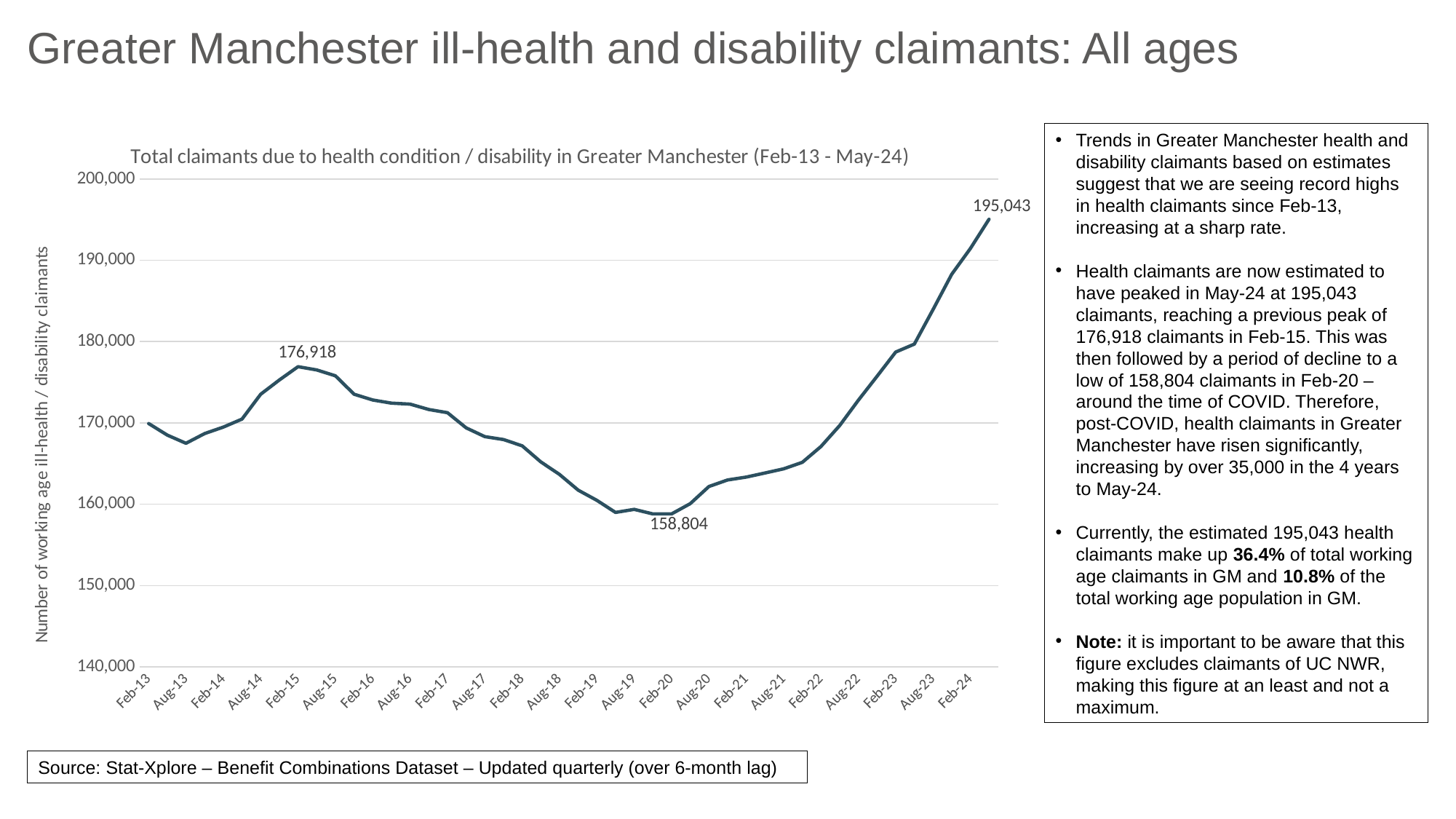
What is the lowest value labelled on the chart? 158,804 Does the line rise or fall between Feb-20 and the end of the series? Rise What is the labelled value of claimants at Feb-20? 158,804 What is the title of the chart? Total claimants due to health condition / disability in Greater Manchester (Feb-13 - May-24) Which is larger, the value at Feb-15 or the value at Feb-20? Feb-15 What is the labelled value of claimants at Feb-15? 176,918 What is the difference between the final labelled value (195,043) and the Feb-15 value (176,918)? 18,125 What type of chart is shown on the slide? Line chart What is the labelled value at the final data point of the line (May-24)? 195,043 Is the value for Aug-13 greater or less than 170,000? less What is the difference between the Feb-15 value (176,918) and the Feb-20 value (158,804)? 18,114 What is the highest value labelled on the chart? 195,043